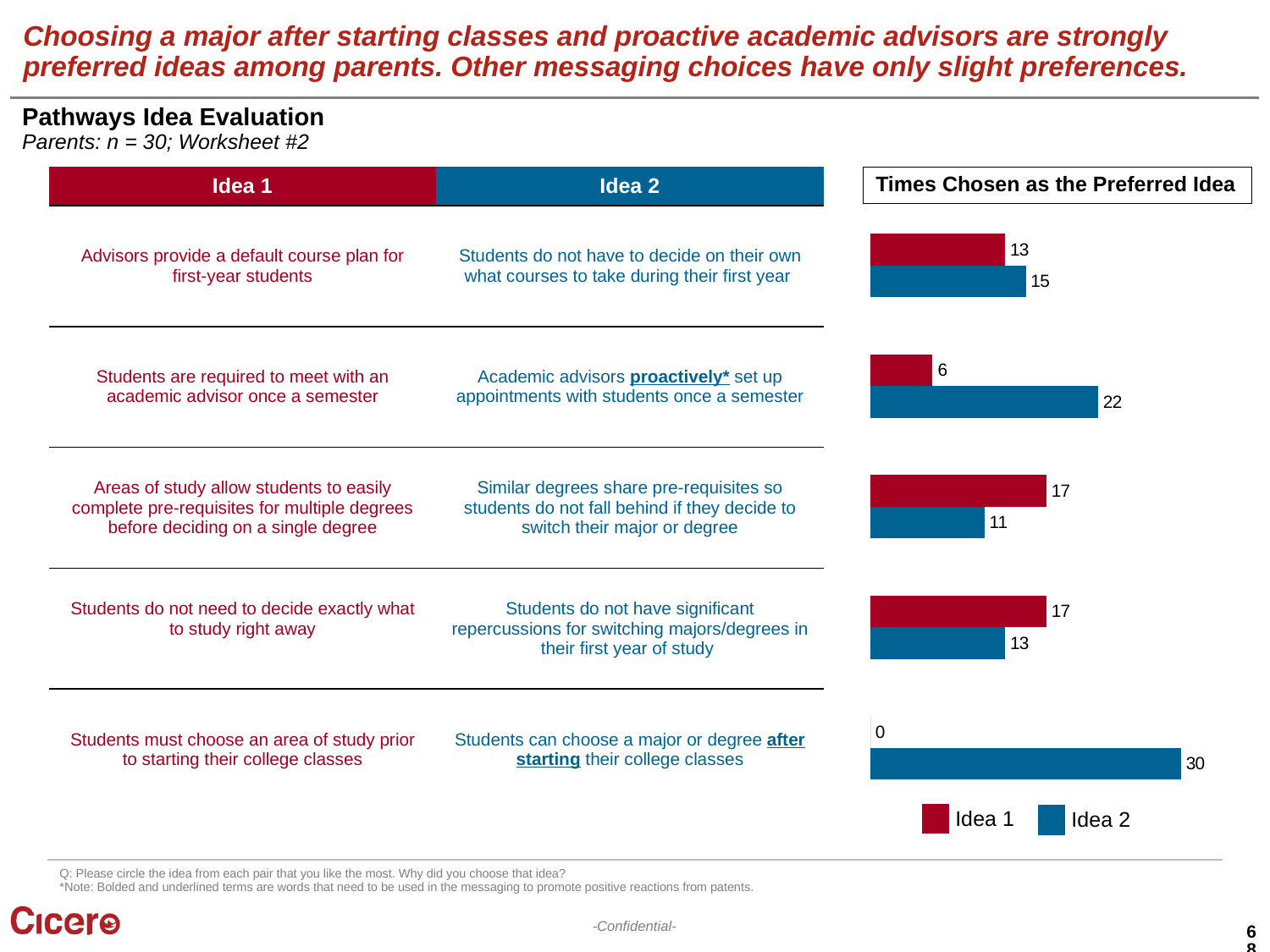
In the 'Times Chosen as the Preferred Idea' chart, how many times was Idea 2 'Similar degrees share pre-requisites so students do not fall behind if they decide to switch their major or degree' chosen? 11 In the 'Times Chosen as the Preferred Idea' chart, how many times was Idea 1 'Students must choose an area of study prior to starting their college classes' chosen? 0 In the 'Times Chosen as the Preferred Idea' chart, how many times was Idea 1 'Advisors provide a default course plan for first-year students' chosen? 13 How many pairs of ideas are plotted in the 'Times Chosen as the Preferred Idea' chart? 5 In the 'Times Chosen as the Preferred Idea' chart, how many times was Idea 2 'Academic advisors proactively set up appointments with students once a semester' chosen? 22 In the 'Times Chosen as the Preferred Idea' chart, which idea has the highest number of times chosen? Students can choose a major or degree after starting their college classes (Idea 2) How many series does the legend of the 'Times Chosen as the Preferred Idea' chart list? 2 In the 'Times Chosen as the Preferred Idea' chart, which idea has the lowest number of times chosen? Students must choose an area of study prior to starting their college classes (Idea 1) In the 'Times Chosen as the Preferred Idea' chart, what is the difference between the times chosen for Idea 2 and Idea 1 in the pair about meeting with an academic advisor once a semester? 16 What type of chart is 'Times Chosen as the Preferred Idea'? Bar chart In the 'Times Chosen as the Preferred Idea' chart, which was chosen more often: 'Advisors provide a default course plan for first-year students' or 'Students do not have to decide on their own what courses to take during their first year'? Students do not have to decide on their own what courses to take during their first year In the 'Times Chosen as the Preferred Idea' chart, what is the total of Idea 1 and Idea 2 times chosen for the pair about deciding what to study right away / repercussions for switching majors? 30